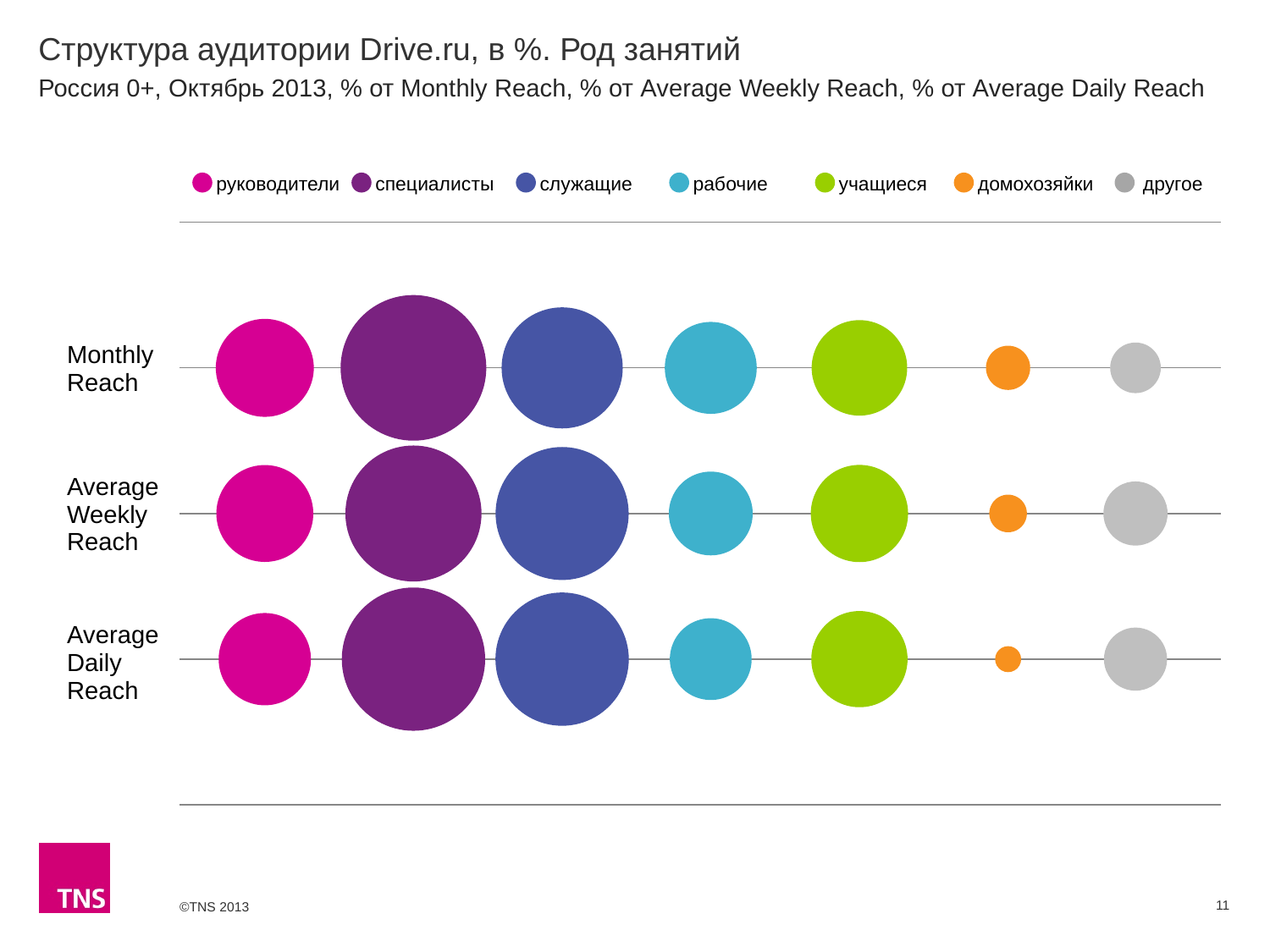
Which occupation group has the largest bubble in the Average Weekly Reach row? специалисты Which occupation group has the largest bubble in the Monthly Reach row? специалисты How many reach categories (rows) are plotted on the chart? 3 What colour represents учащиеся in the legend? green Which occupation group has the smallest bubble in the Monthly Reach row? домохозяйки What is the title of the chart on the slide? Структура аудитории Drive.ru, в %. Род занятий What kind of chart is shown on the slide? bubble chart In the Monthly Reach row, which bubble is larger: руководители or рабочие? руководители In the Average Weekly Reach row, which bubble is larger: другое or домохозяйки? другое Which occupation group has the smallest bubble in the Average Daily Reach row? домохозяйки In the Average Daily Reach row, which bubble is larger: служащие or учащиеся? служащие How many series does the legend list? 7